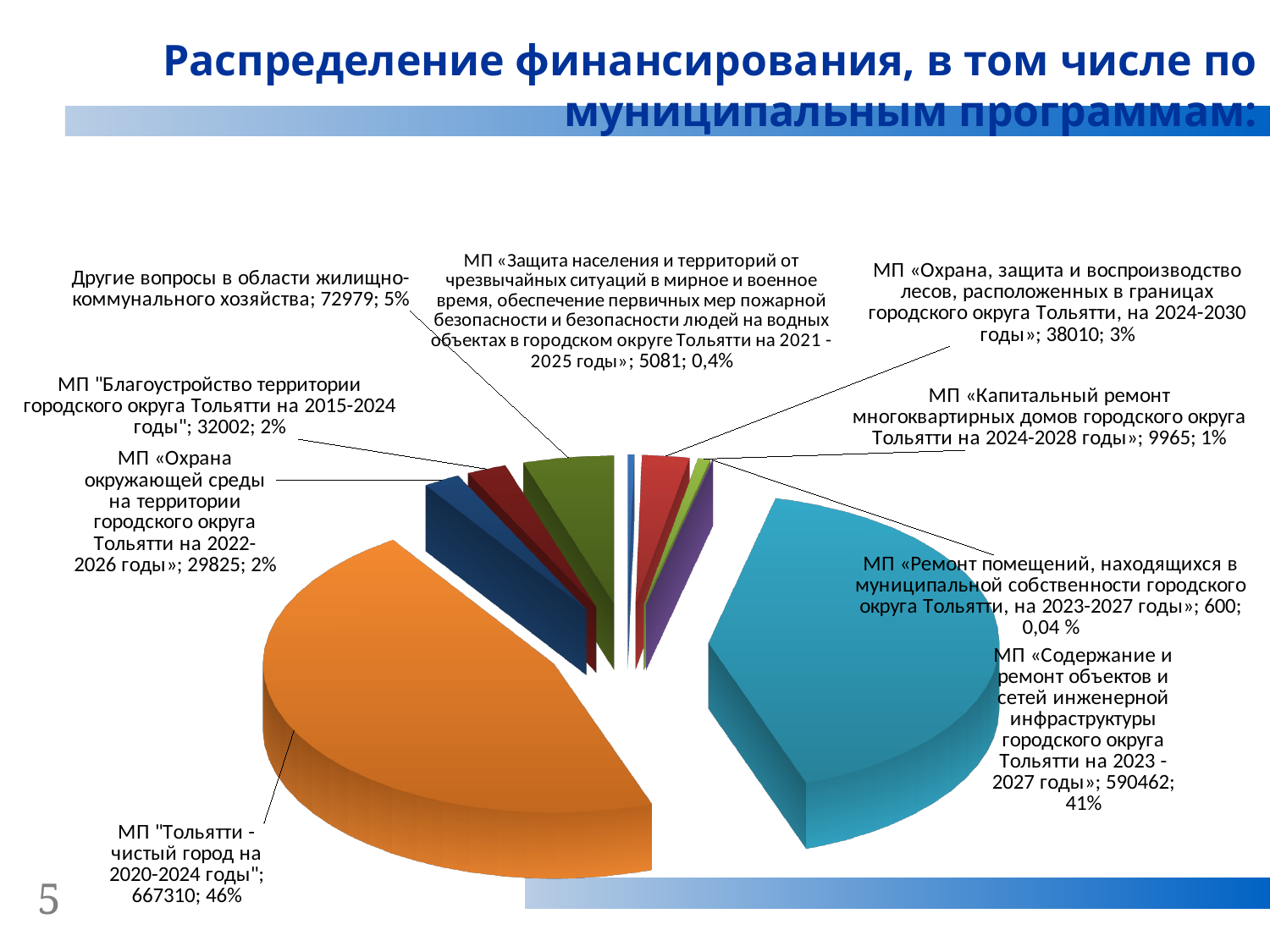
What is the value for МП «Содержание и ремонт объектов и сетей инженерной инфраструктуры городского округа Тольятти на 2023 - 2027 годы»? 590462 What is the value for МП "Тольятти - чистый город на 2020-2024 годы"? 667310 What is the title of the slide containing the pie chart? Распределение финансирования, в том числе по муниципальным программам: Which is larger: the value for МП "Благоустройство территории городского округа Тольятти на 2015-2024 годы" or the value for МП «Капитальный ремонт многоквартирных домов городского округа Тольятти на 2024-2028 годы»? МП "Благоустройство территории городского округа Тольятти на 2015-2024 годы" What kind of chart is shown on the slide? Pie chart What is the value for МП «Охрана, защита и воспроизводство лесов, расположенных в границах городского округа Тольятти, на 2024-2030 годы»? 38010 What is the value for Другие вопросы в области жилищно-коммунального хозяйства? 72979 Which slice is the smallest in the pie chart? МП «Ремонт помещений, находящихся в муниципальной собственности городского округа Тольятти, на 2023-2027 годы» How many slices does the pie chart have? 9 What share of the pie does МП «Содержание и ремонт объектов и сетей инженерной инфраструктуры городского округа Тольятти на 2023 - 2027 годы» represent? 41% What is the difference between the values for МП "Тольятти - чистый город на 2020-2024 годы" and МП «Содержание и ремонт объектов и сетей инженерной инфраструктуры городского округа Тольятти на 2023 - 2027 годы»? 76848 Which slice is the largest in the pie chart? МП "Тольятти - чистый город на 2020-2024 годы"